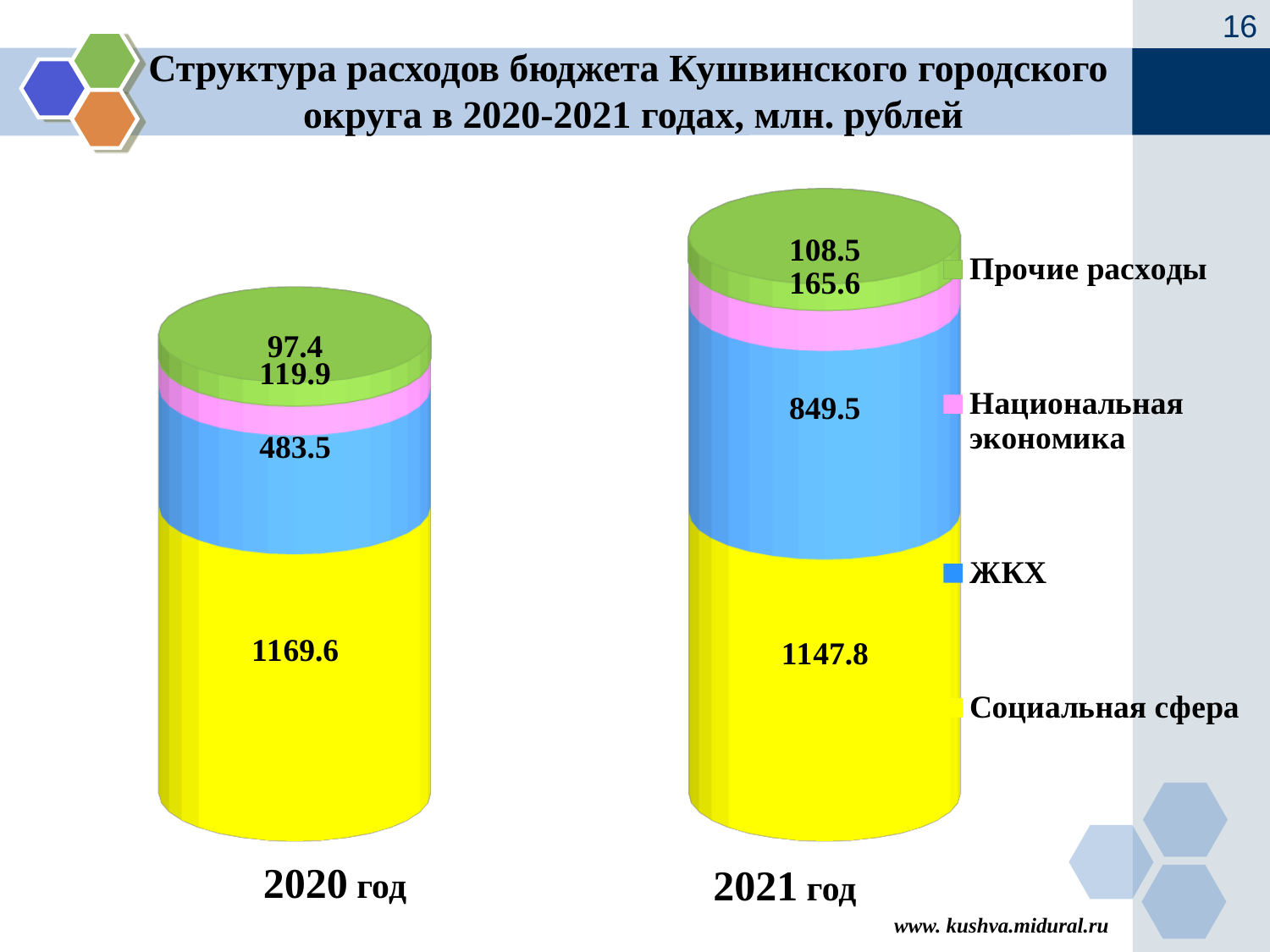
What is the difference between the ЖКХ values for 2021 год and 2020 год? 366.0 What is the value for ЖКХ in 2021 год? 849.5 What is the total of the stacked bar for 2020 год? 1870.4 What is the value for Социальная сфера in 2020 год? 1169.6 What kind of chart is shown on the slide? Stacked bar chart What is the value for Национальная экономика in 2021 год? 165.6 How many categories (years) are shown on the chart? 2 What is the value for Прочие расходы in 2020 год? 97.4 How many series does the legend list? 4 Which is larger: Социальная сфера in 2020 год or in 2021 год? 2020 год Which series has the largest value in 2021 год? Социальная сфера Which series has the smallest value in 2020 год? Прочие расходы